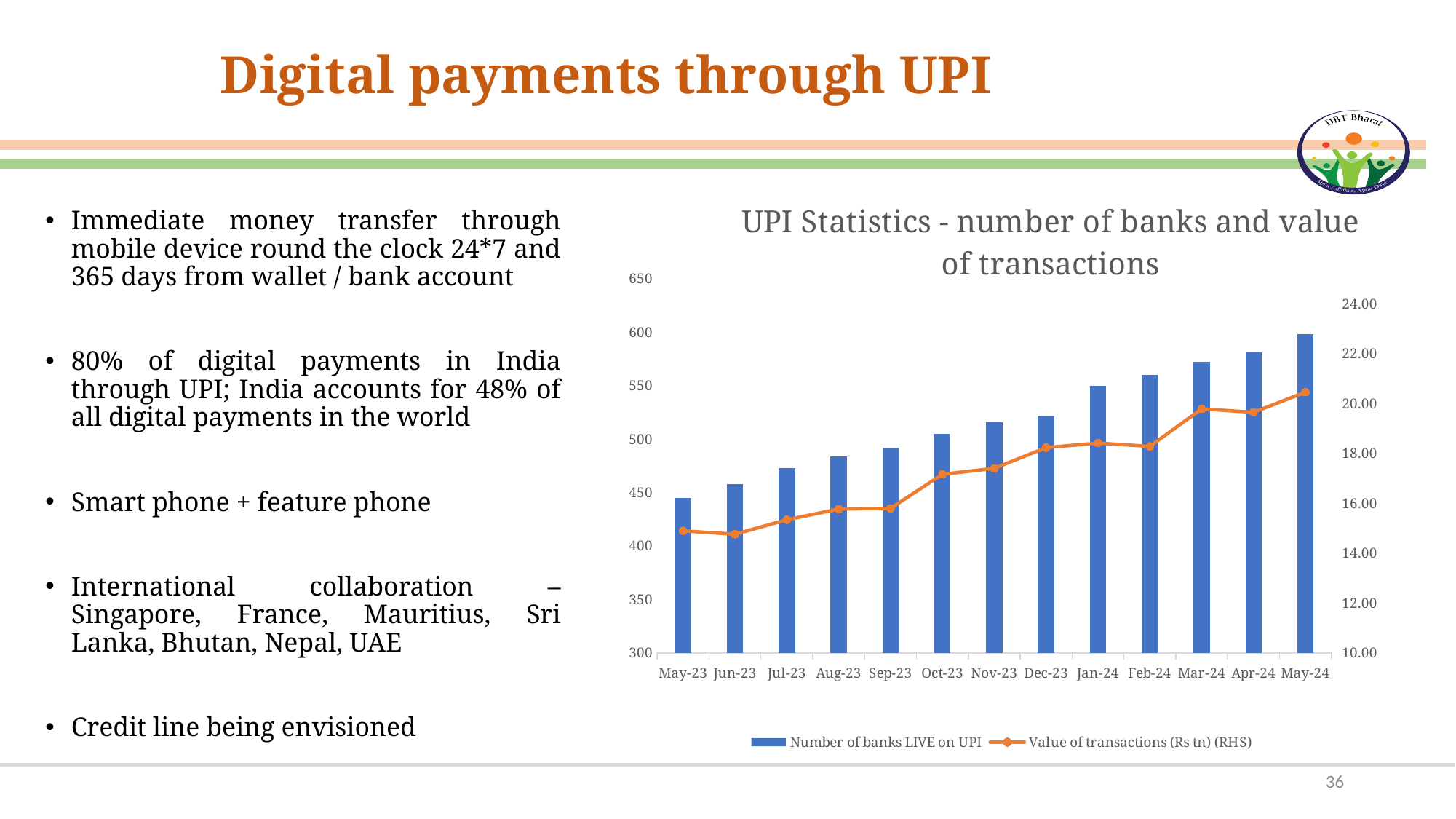
Is the number of banks LIVE on UPI in Mar-24 greater or less than 550? greater What is the title of the chart? UPI Statistics - number of banks and value of transactions How many months are plotted along the x axis of the chart? 13 Which month has more banks LIVE on UPI, Sep-23 or Dec-23? Dec-23 Is the value of transactions (Rs tn) in May-24 greater or less than 18.00? greater Does the number of banks LIVE on UPI rise or fall from May-23 to May-24? Rise Is the value of transactions (Rs tn) in May-23 greater or less than 16.00? less Which month has the highest number of banks LIVE on UPI? May-24 How many series does the chart legend list? 2 Which month has the lowest number of banks LIVE on UPI? May-23 What kind of chart is shown on the slide? A combined bar and line chart